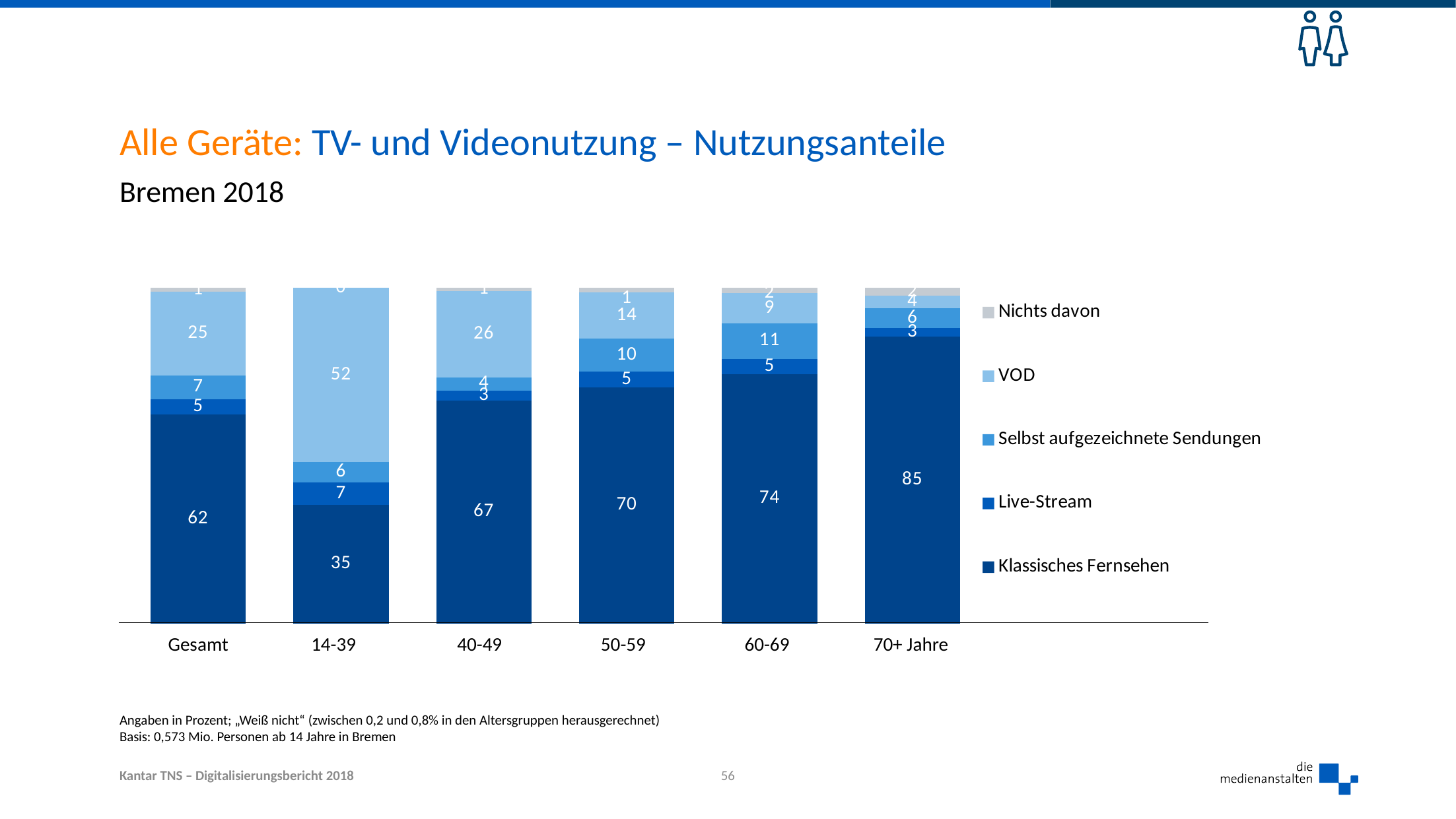
What is the value for Selbst aufgezeichnete Sendungen in the 60-69 age group? 11 Which is larger: the VOD value for Gesamt or the VOD value for 50-59? Gesamt How many series does the legend list? 5 What is the difference between the Klassisches Fernsehen values for 70+ Jahre and 14-39? 50 Which series is shown in the darkest blue at the bottom of each bar? Klassisches Fernsehen Which age group has the highest value for Klassisches Fernsehen? 70+ Jahre How many categories are shown along the x axis? 6 What is the value for VOD in the 14-39 age group? 52 Which category has the lowest value for VOD? 70+ Jahre What is the value for Klassisches Fernsehen in the 70+ Jahre group? 85 What is the value for Klassisches Fernsehen in the 14-39 age group? 35 What kind of chart is shown on the slide? stacked bar chart